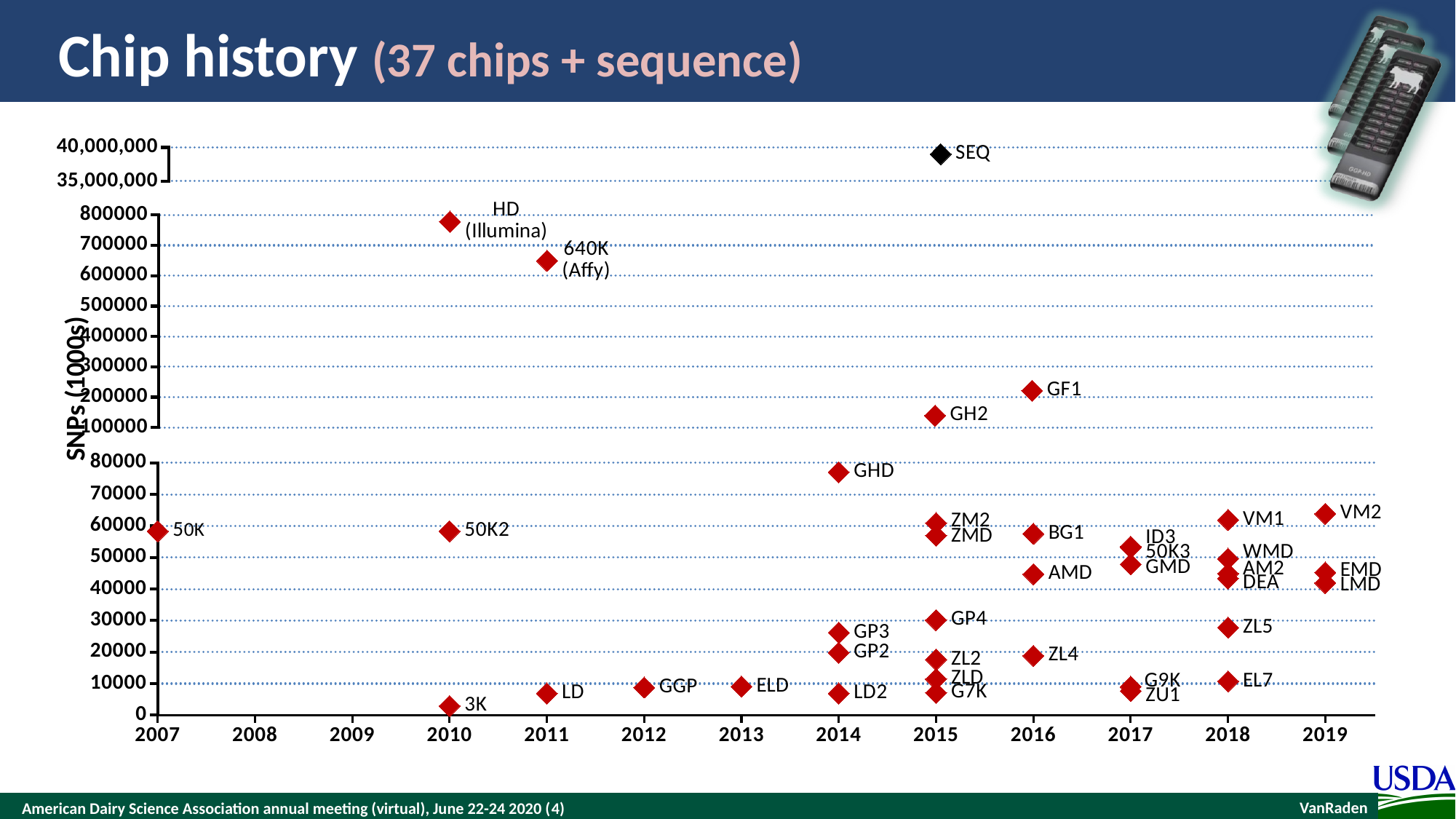
What is the label of the y axis? SNPs (1000s) Is the value for GH2 greater or less than 100000? greater Which chip has the lowest value on the chart? 3K Which has the larger value, GF1 or GH2? GF1 Is the value for HD (Illumina) greater or less than 700000? greater What kind of chart is shown on the slide? scatter chart Which has the larger value, GHD or GP3? GHD Is the value for AMD greater or less than 50000? less How many chips are plotted in 2010? 3 Which point has the highest value on the chart? SEQ What is the title of the slide? Chip history (37 chips + sequence)